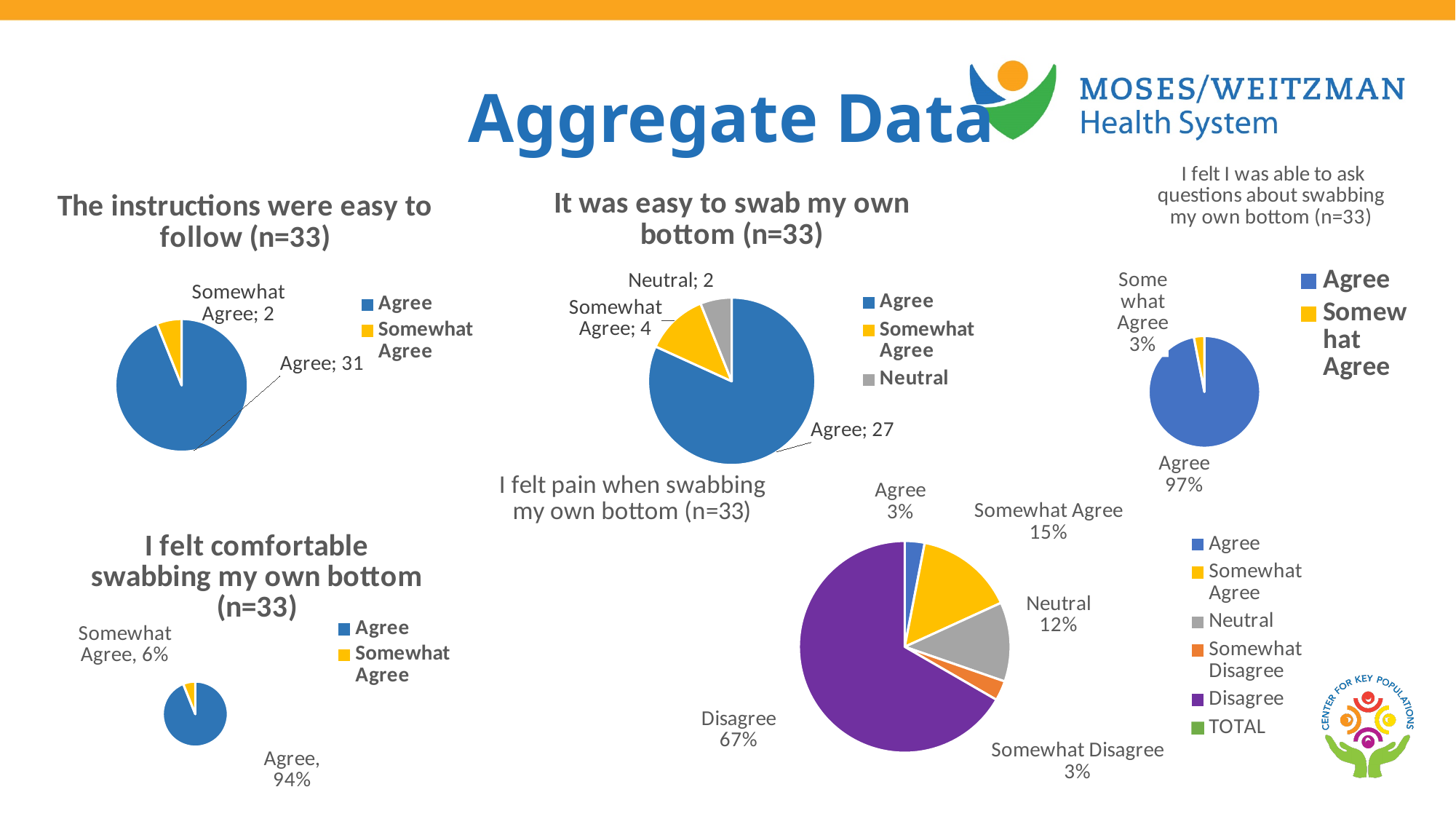
What type of chart is used for "I felt pain when swabbing my own bottom (n=33)"? Pie chart In the chart titled "It was easy to swab my own bottom (n=33)", which category has the largest slice? Agree In the chart titled "I felt pain when swabbing my own bottom (n=33)", how many entries does the legend list? 6 In the chart titled "I felt I was able to ask questions about swabbing my own bottom (n=33)", what share of the pie is Agree? 97% In the chart titled "It was easy to swab my own bottom (n=33)", what is the difference between the Agree and Somewhat Agree values? 23 In the chart titled "It was easy to swab my own bottom (n=33)", what is the value for Neutral? 2 In the chart titled "I felt pain when swabbing my own bottom (n=33)", which is larger, Somewhat Agree or Neutral? Somewhat Agree In the chart titled "I felt comfortable swabbing my own bottom (n=33)", what share of the pie is Somewhat Agree? 6% In the chart titled "The instructions were easy to follow (n=33)", what is the value for Agree? 31 In the chart titled "I felt pain when swabbing my own bottom (n=33)", what share of the pie is Disagree? 67% In the chart titled "It was easy to swab my own bottom (n=33)", how many slices does the pie have? 3 In the chart titled "The instructions were easy to follow (n=33)", what is the value for Somewhat Agree? 2